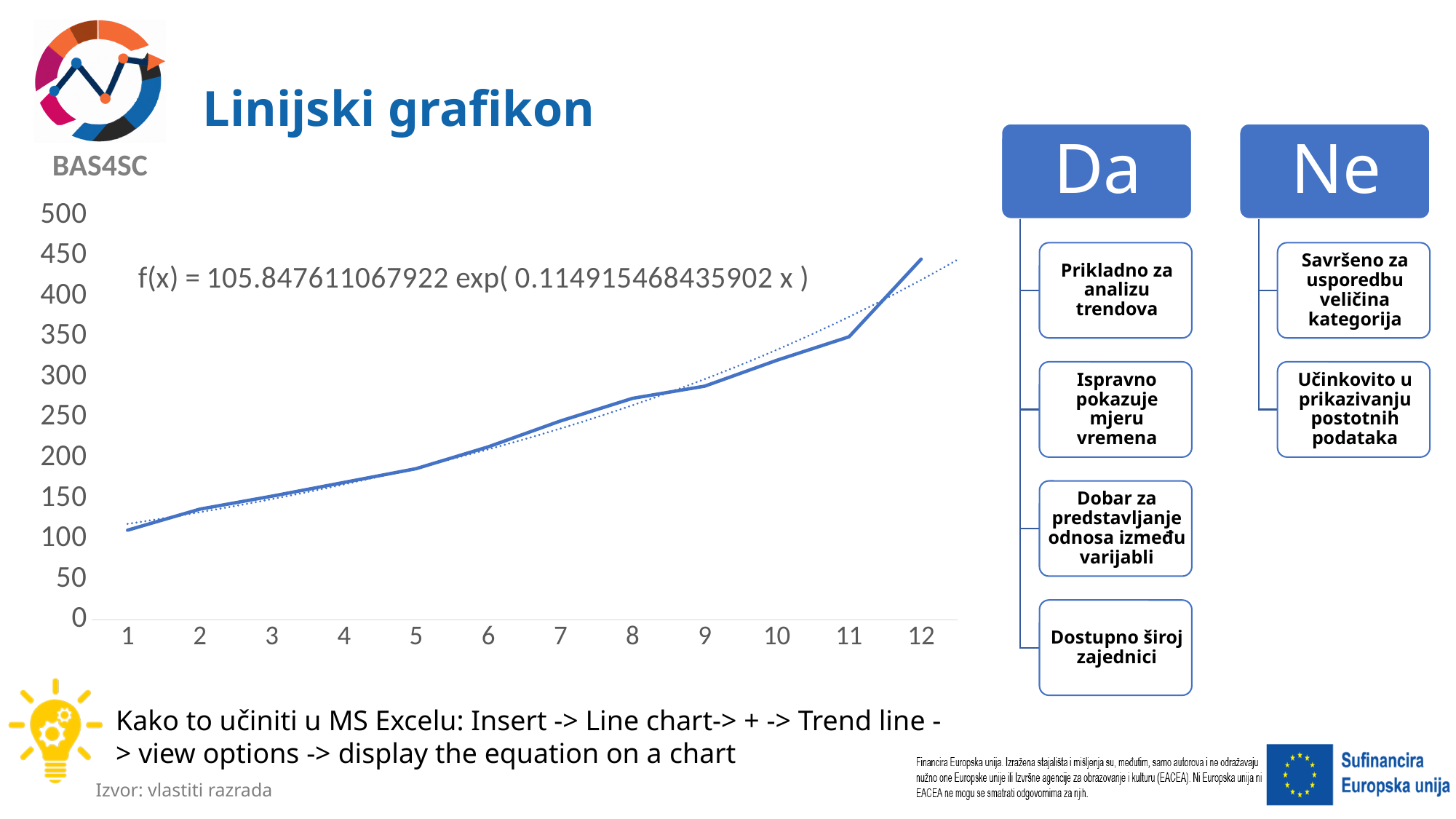
Is the value at x = 3 greater or less than 200? less Do the values in the line chart rise or fall as x goes from 1 to 12? rise Is the value at x = 12 greater or less than 400? greater How many points are plotted along the x axis of the line chart? 12 Which is larger, the value at x = 12 or the value at x = 1? x = 12 Is the value at x = 1 greater or less than 150? less At which x value is the line chart highest? 12 What trendline equation is displayed on the chart? f(x) = 105.847611067922 exp( 0.114915468435902 x ) At which x value is the line chart lowest? 1 What kind of chart is shown on the slide? line chart